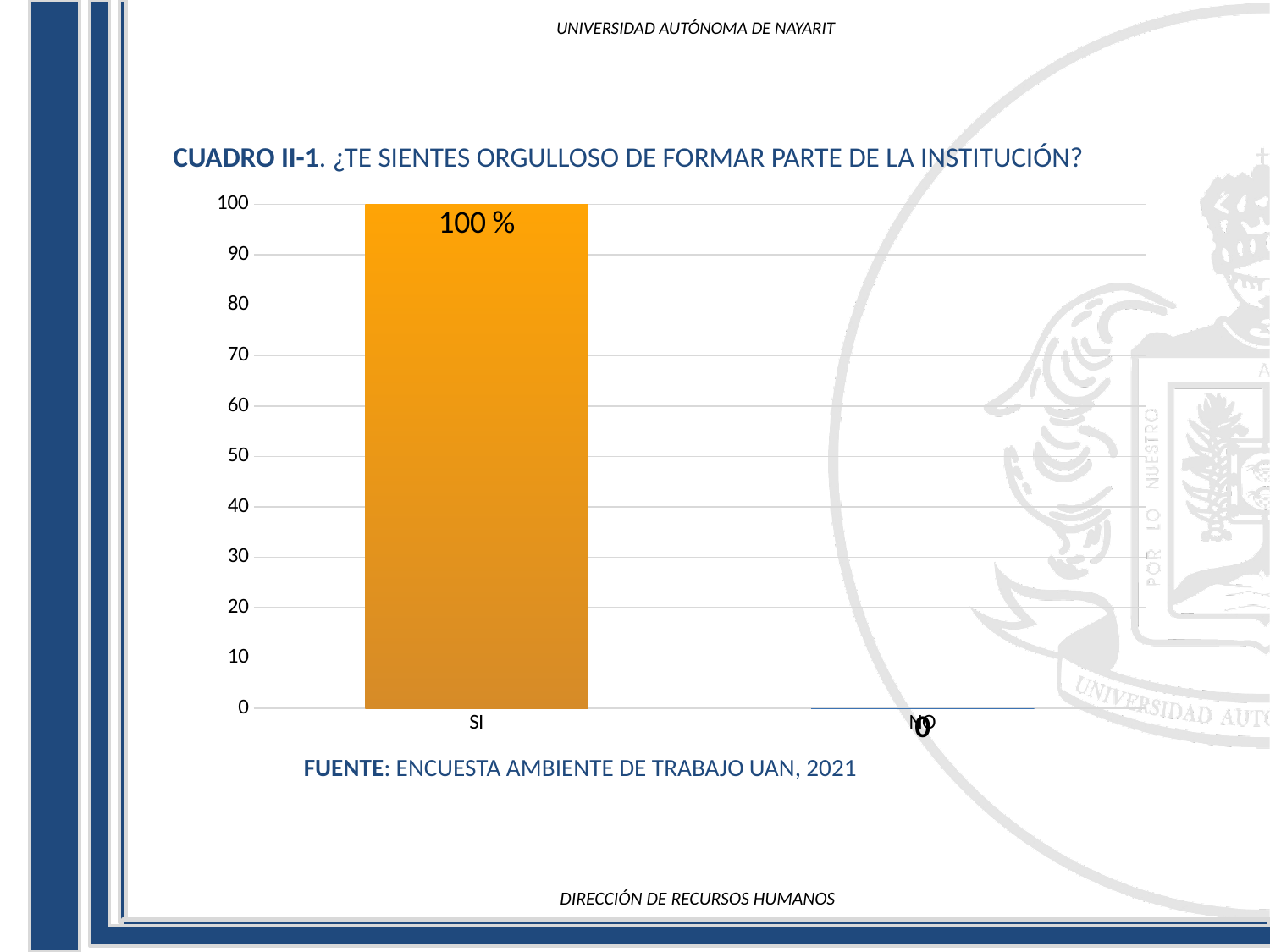
What is the title of the chart? CUADRO II-1. ¿TE SIENTES ORGULLOSO DE FORMAR PARTE DE LA INSTITUCIÓN? What kind of chart is shown on the slide? bar chart What is the value shown for the SI category? 100 % Is the value for SI greater or less than 50? greater What source is cited below the chart? ENCUESTA AMBIENTE DE TRABAJO UAN, 2021 Which category has the lowest value? NO How many categories are shown on the x axis? 2 What is the difference between the value for SI and the value for NO? 100 Which is larger, the value for SI or the value for NO? SI Which category has the highest value? SI What is the value shown for the NO category? 0 What is the highest tick value shown on the y axis? 100